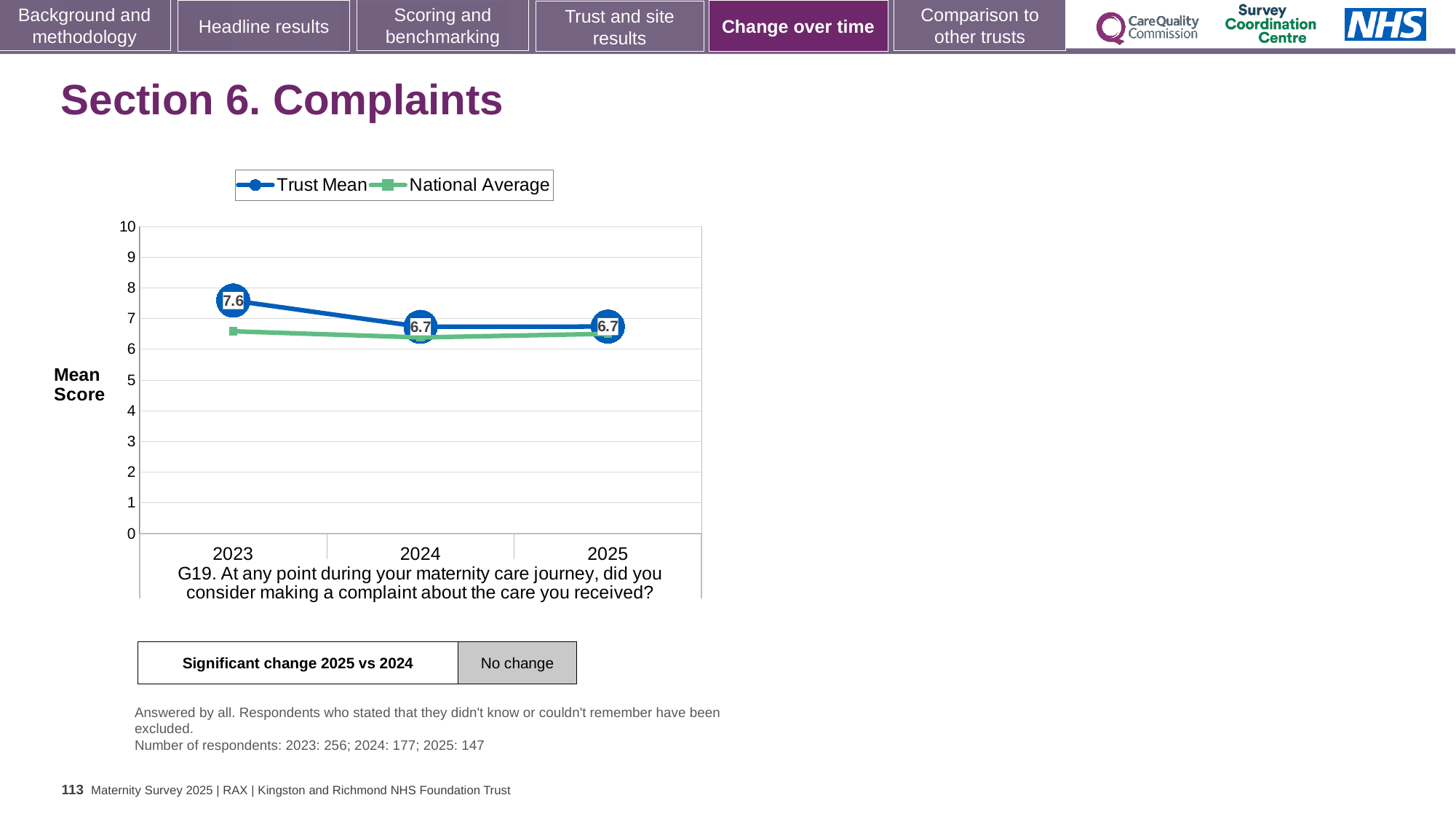
How many series does the legend list? 2 What is the Trust Mean score for 2023? 7.6 What kind of chart is shown on the slide? line chart Is the National Average value for 2024 greater or less than 6? greater How many years are plotted on the x axis? 3 What is the difference between the Trust Mean score in 2023 and in 2024? 0.9 In 2023, which is larger: the Trust Mean or the National Average? Trust Mean What is the Trust Mean score for 2025? 6.7 Does the Trust Mean rise or fall from 2023 to 2024? fall In which year is the Trust Mean score highest? 2023 What is the Trust Mean score for 2024? 6.7 Is the National Average value for 2023 greater or less than 7? less